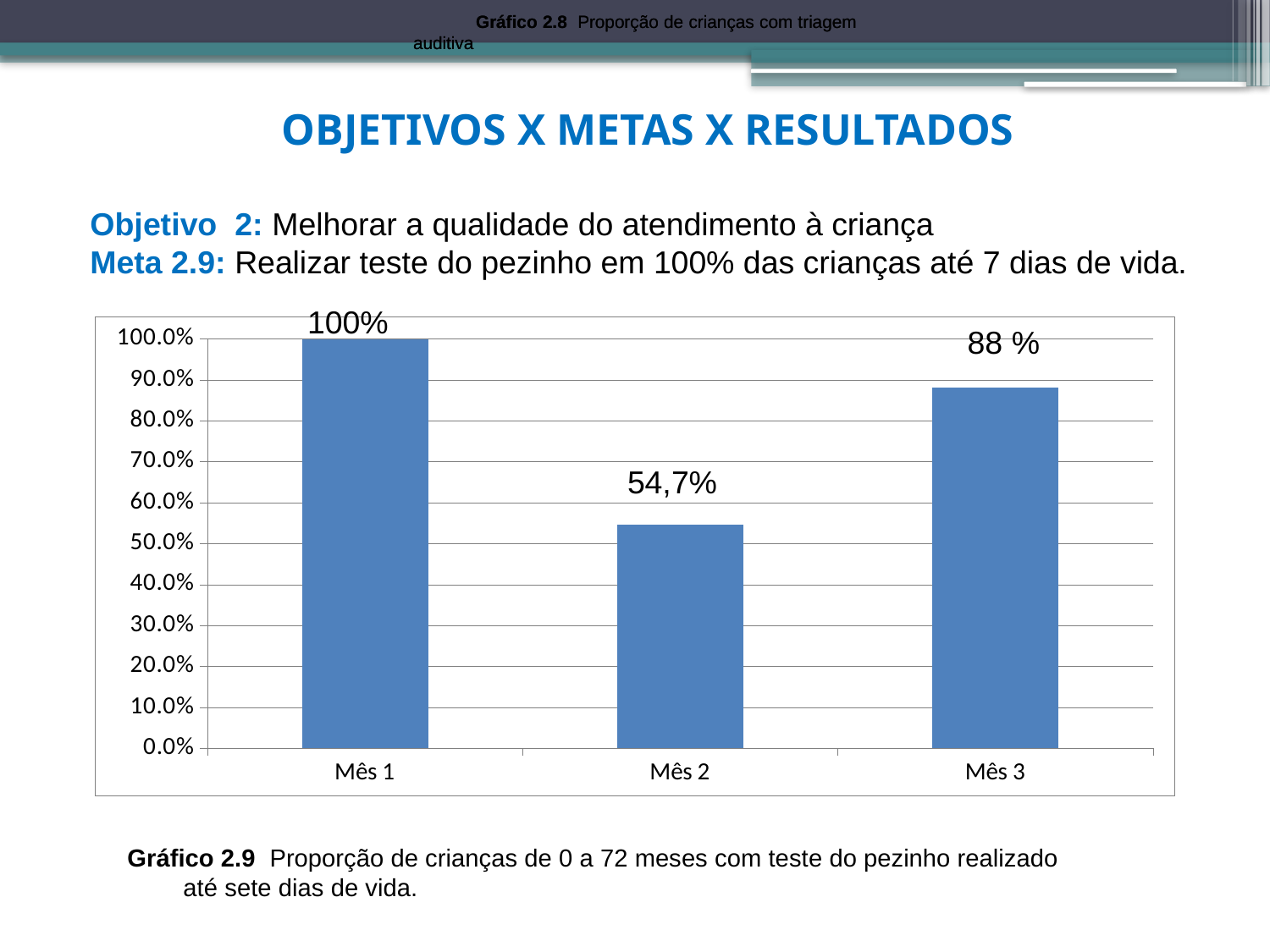
Does the value rise or fall from Mês 1 to Mês 2? fall How many months are shown on the x axis? 3 What is the value for Mês 2? 54,7% Is the value for Mês 2 greater or less than 60.0%? less What is the difference between the values for Mês 3 and Mês 2? 33,3% What kind of chart is shown on the slide? bar chart What is the difference between the values for Mês 1 and Mês 2? 45,3% Which is larger, the value for Mês 2 or the value for Mês 3? Mês 3 What is the value for Mês 3? 88 % Which month has the highest value? Mês 1 Which month has the lowest value? Mês 2 What is the value for Mês 1? 100%